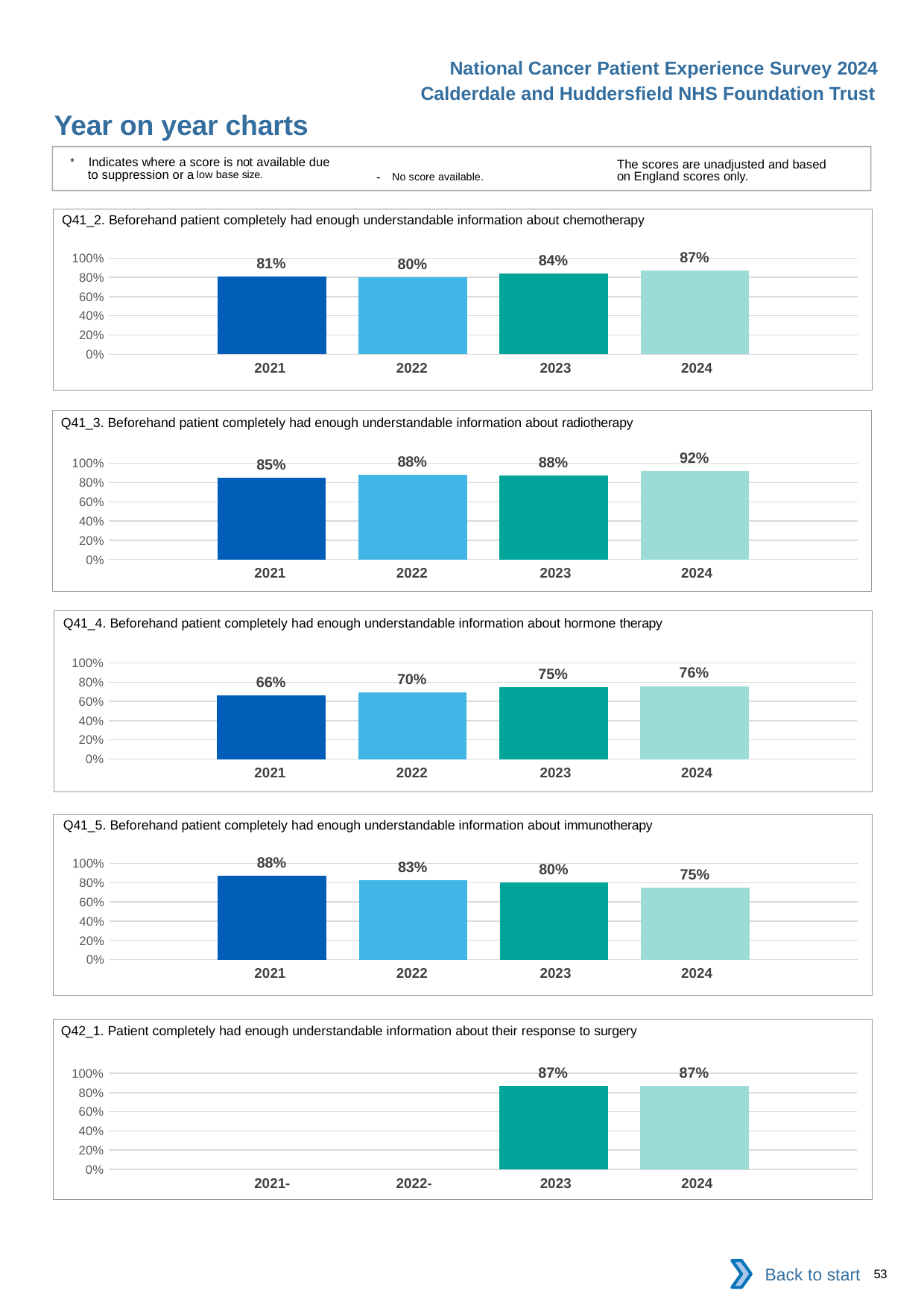
In the Q41_4 chart about hormone therapy, do the values rise or fall from 2021 to 2024? rise In the Q41_4 chart about hormone therapy, what is the value for 2022? 70% In the Q41_2 chart about chemotherapy, what is the value for 2024? 87% In the Q41_5 chart about immunotherapy, do the values rise or fall from 2021 to 2024? fall In the Q41_5 chart about immunotherapy, which is larger, the value for 2021 or the value for 2024? 2021 In the Q42_1 chart about response to surgery, how many years have a bar plotted? 2 In the Q41_4 chart about hormone therapy, which year has the highest value? 2024 What type of chart is the Q42_1 chart about response to surgery? bar chart In the Q41_2 chart about chemotherapy, which year has the lowest value? 2022 In the Q41_3 chart about radiotherapy, what is the difference between the 2024 and 2021 values? 7 percentage points In the Q41_3 chart about radiotherapy, what is the value for 2021? 85% In the Q41_5 chart about immunotherapy, what is the difference between the 2021 and 2024 values? 13 percentage points